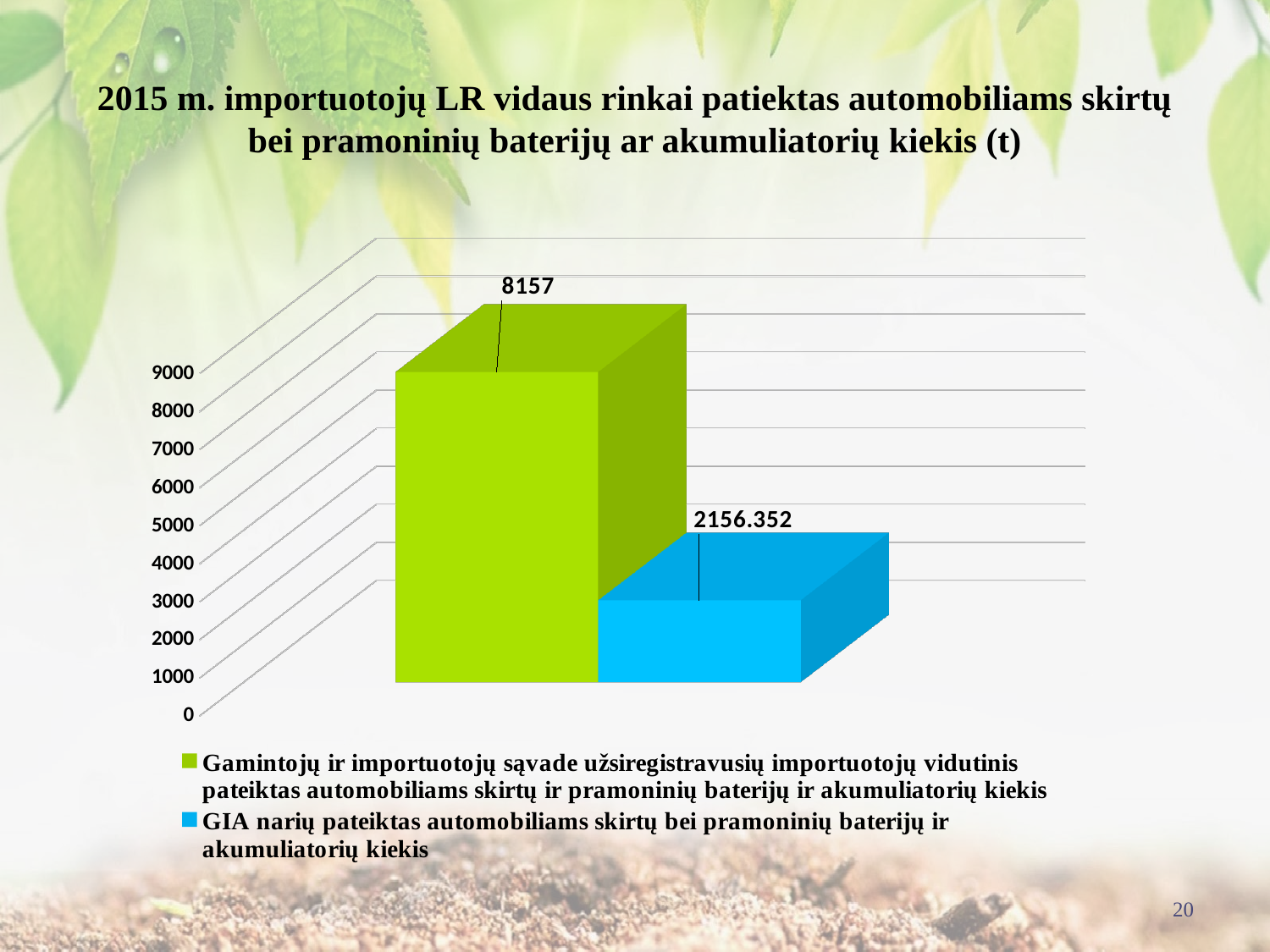
What colour is the bar for the GIA narių series? blue What is the difference between the value 8157 and the value 2156.352 shown on the chart? 6000.648 Is the value for the Gamintojų ir importuotojų sąvade series greater or less than 7000? greater How many series does the legend list? 2 Is the value for the GIA narių series greater or less than 3000? less What kind of chart is shown on the slide? bar chart What value is shown for the series 'GIA narių pateiktas automobiliams skirtų bei pramoninių baterijų ir akumuliatorių kiekis'? 2156.352 Is the value for the GIA narių series larger or smaller than the value for the Gamintojų ir importuotojų sąvade series? smaller How many bars are plotted on the chart? 2 Which series has the higher value? Gamintojų ir importuotojų sąvade užsiregistravusių importuotojų vidutinis pateiktas automobiliams skirtų ir pramoninių baterijų ir akumuliatorių kiekis What value is shown for the series 'Gamintojų ir importuotojų sąvade užsiregistravusių importuotojų vidutinis pateiktas automobiliams skirtų ir pramoninių baterijų ir akumuliatorių kiekis'? 8157 Which series has the lower value? GIA narių pateiktas automobiliams skirtų bei pramoninių baterijų ir akumuliatorių kiekis